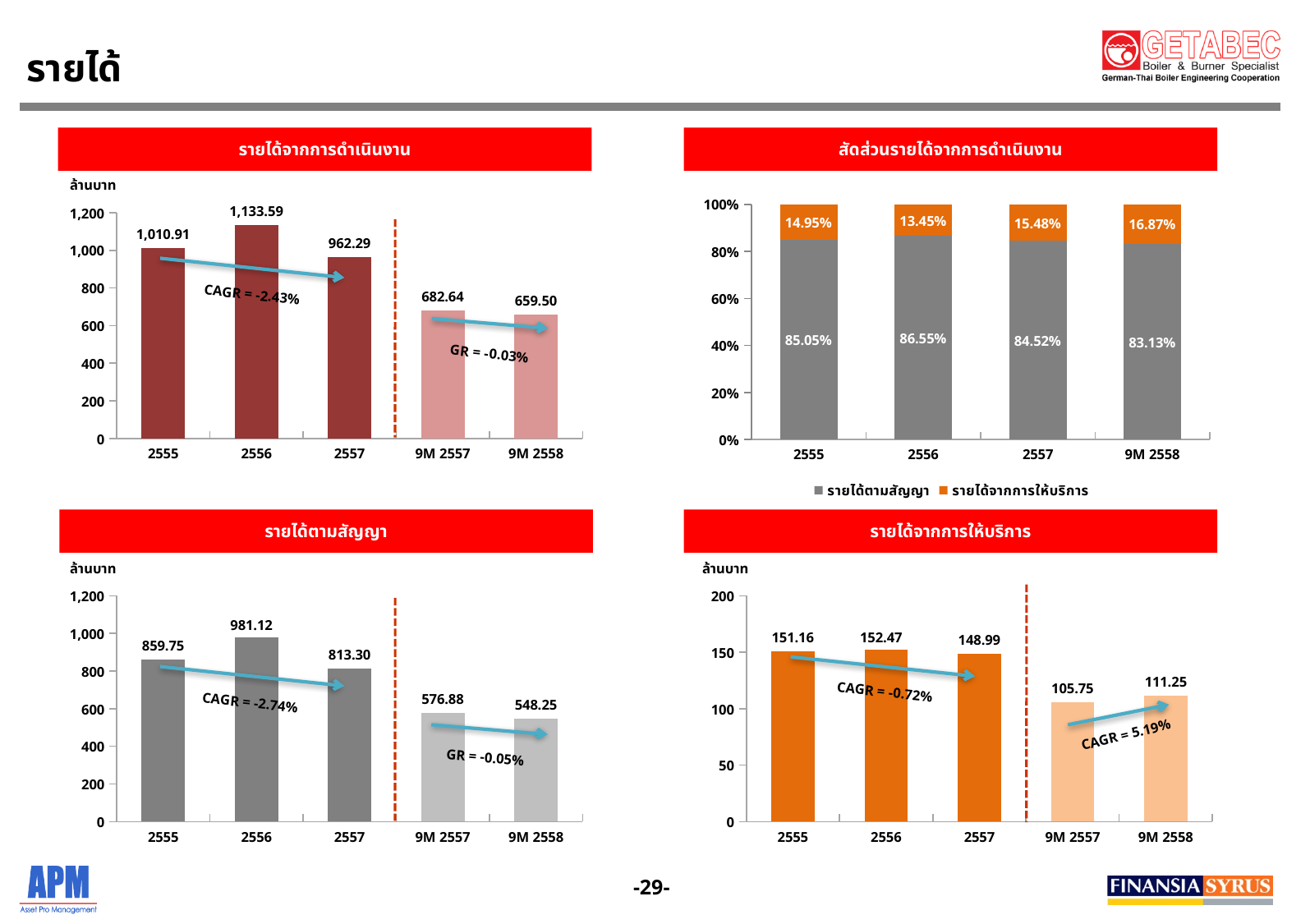
In the bottom-right chart (รายได้จากการให้บริการ), which is larger, the value for 9M 2557 or 9M 2558? 9M 2558 In the top-right chart (สัดส่วนรายได้จากการดำเนินงาน), which year has the highest share for รายได้ตามสัญญา? 2556 What kind of chart is the bottom-right chart (รายได้จากการให้บริการ)? Bar chart In the bottom-right chart (รายได้จากการให้บริการ), what is the value for 2555? 151.16 In the bottom-left chart (รายได้ตามสัญญา), what is the value for 2557? 813.30 In the top-left chart (รายได้จากการดำเนินงาน), what is the difference between the 9M 2557 and 9M 2558 values? 23.14 In the top-right chart (สัดส่วนรายได้จากการดำเนินงาน), how many series does the legend list? 2 In the top-right chart (สัดส่วนรายได้จากการดำเนินงาน), what is the percentage for รายได้จากการให้บริการ in 9M 2558? 16.87% In the top-left chart (รายได้จากการดำเนินงาน), how many bars are plotted? 5 In the bottom-left chart (รายได้ตามสัญญา), which category has the lowest value? 9M 2558 In the top-left chart (รายได้จากการดำเนินงาน), what is the value for 2556? 1,133.59 In the top-left chart (รายได้จากการดำเนินงาน), which category has the highest value? 2556